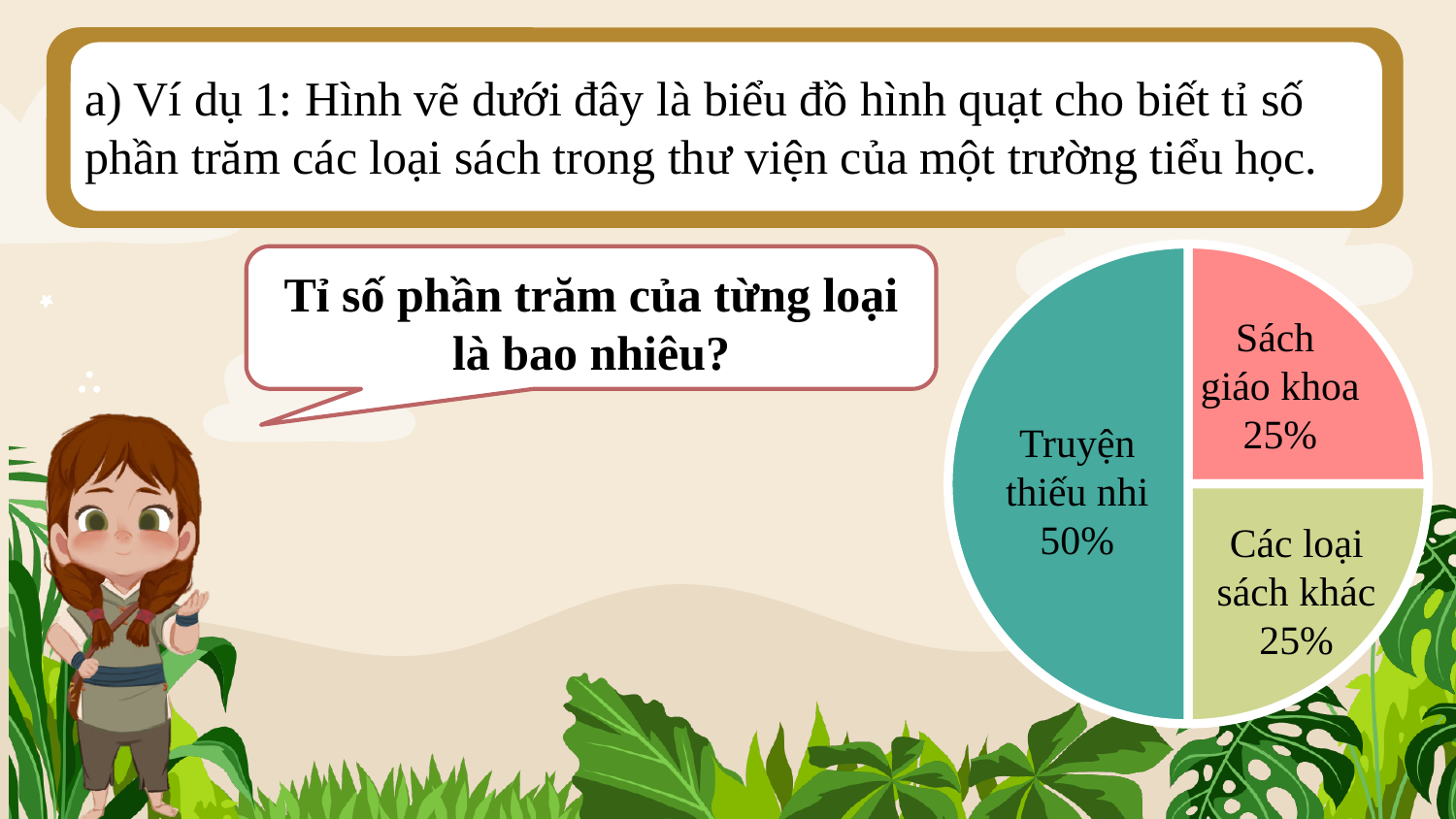
What is the difference between the share of Truyện thiếu nhi and the share of Sách giáo khoa? 25% Which is larger, the share of Truyện thiếu nhi or the share of Các loại sách khác? Truyện thiếu nhi What percentage of the books are Truyện thiếu nhi? 50% What is the combined share of Sách giáo khoa and Các loại sách khác? 50% What share of the pie does the Sách giáo khoa slice represent? 25% How many categories does the pie chart show? 3 What colour is the Truyện thiếu nhi slice? teal What kind of chart is shown on the slide? pie chart What percentage of the books are Sách giáo khoa? 25% What percentage of the books are Các loại sách khác? 25% Which category has the largest share of the pie? Truyện thiếu nhi What colour is the Sách giáo khoa slice? pink